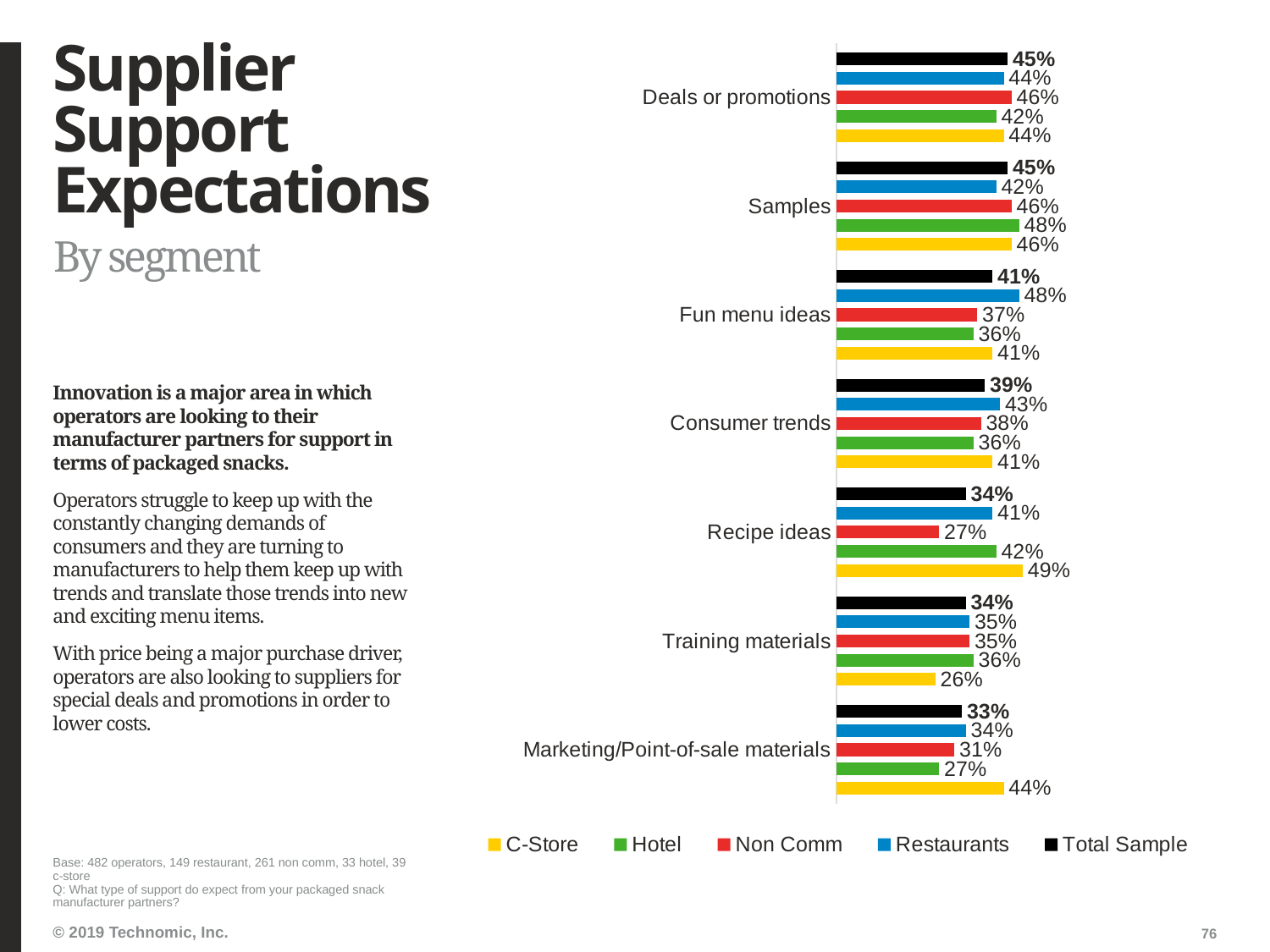
What is the Non Comm value for Marketing/Point-of-sale materials? 31% What type of chart is shown on the slide? Bar chart What is the difference between the C-Store and Non Comm values for Recipe ideas? 22 percentage points What is the Total Sample value for Deals or promotions? 45% Which category has the lowest Total Sample value? Marketing/Point-of-sale materials How many series does the legend list? 5 What percentage of C-Store operators expect Recipe ideas? 49% Which segment has the highest value for Fun menu ideas? Restaurants What is the Hotel value for Samples? 48% Which segment has the lowest value for Training materials? C-Store For Consumer trends, which is larger: the Restaurants value or the Hotel value? Restaurants How many support categories are shown in the chart? 7